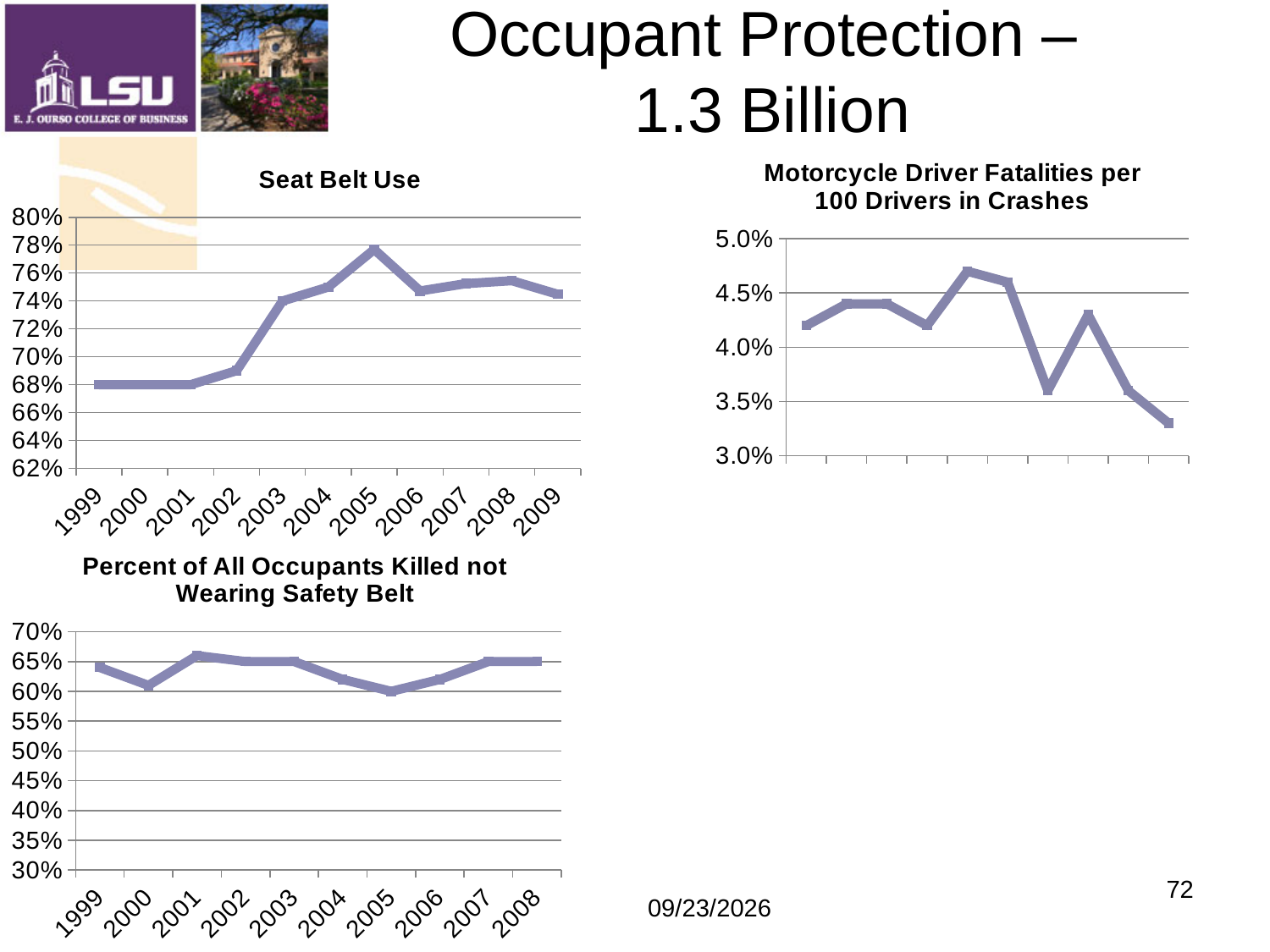
In the Percent of All Occupants Killed not Wearing Safety Belt chart, which is larger, the value for 2000 or the value for 2003? 2003 How many years are plotted in the Seat Belt Use chart? 11 In the Seat Belt Use chart, is the value for 2002 greater or less than 70%? less In the Seat Belt Use chart, which year has the highest seat belt use? 2005 In the Seat Belt Use chart, is the value for 2009 greater or less than 76%? less In the Percent of All Occupants Killed not Wearing Safety Belt chart, is the value for 2001 greater or less than 65%? greater In the Percent of All Occupants Killed not Wearing Safety Belt chart, which year has the lowest value? 2005 In the Seat Belt Use chart, which is larger, the value for 2003 or the value for 2001? 2003 How many data points are plotted in the Motorcycle Driver Fatalities per 100 Drivers in Crashes chart? 10 What kind of chart is the Seat Belt Use chart? line chart